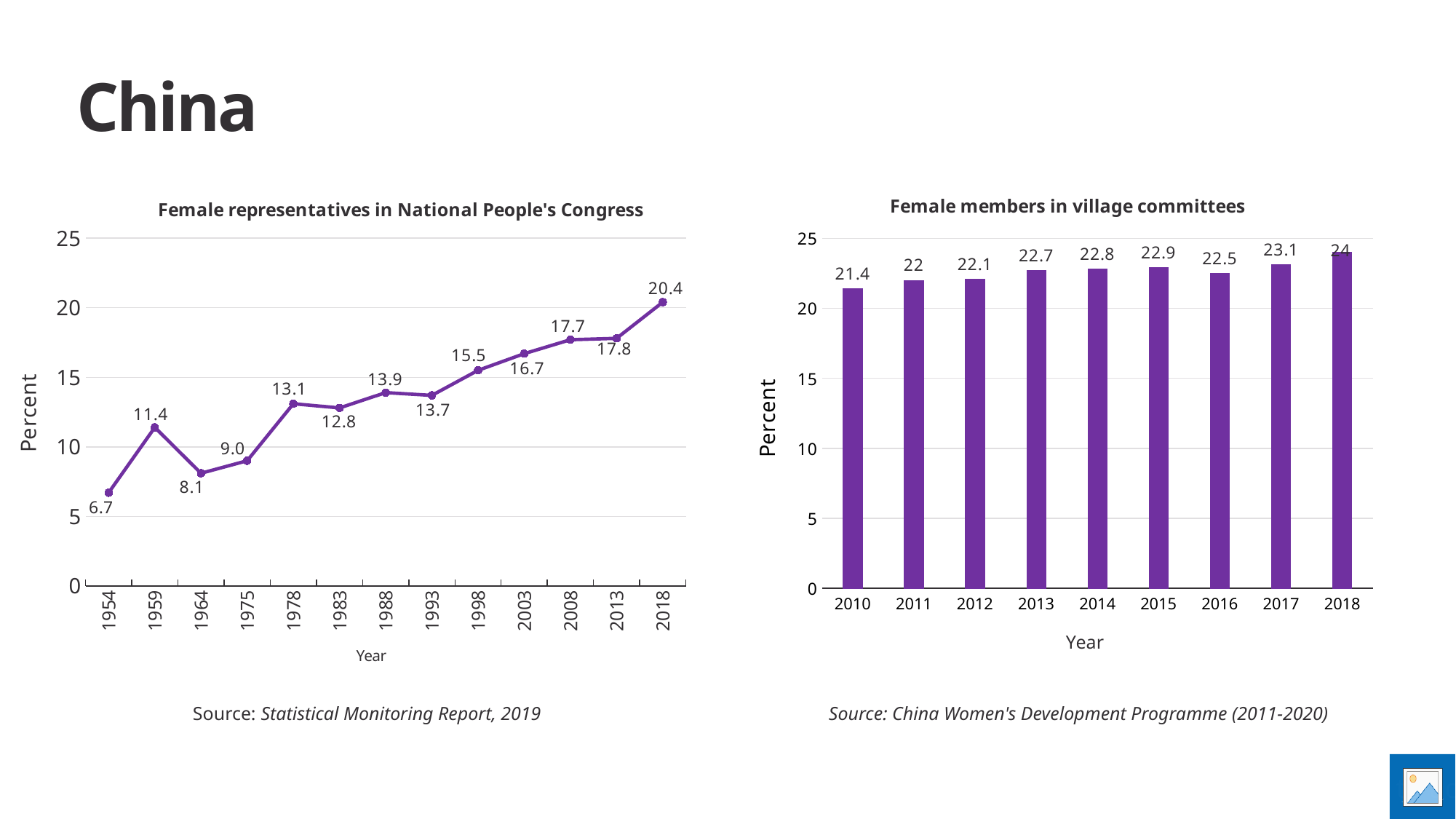
In the 'Female representatives in National People's Congress' chart, what is the value for 2018? 20.4 What kind of chart is 'Female representatives in National People's Congress'? Line chart In the 'Female representatives in National People's Congress' chart, what is the difference between the values for 2018 and 2013? 2.6 In the 'Female representatives in National People's Congress' chart, which is larger, the value for 1959 or the value for 1964? 1959 In the 'Female members in village committees' chart, what is the difference between the values for 2018 and 2010? 2.6 What kind of chart is 'Female members in village committees'? Bar chart In the 'Female representatives in National People's Congress' chart, which year has the lowest value? 1954 How many data points are plotted in the 'Female representatives in National People's Congress' chart? 13 In the 'Female members in village committees' chart, what is the value for 2013? 22.7 In the 'Female representatives in National People's Congress' chart, what is the value for 1954? 6.7 How many bars are in the 'Female members in village committees' chart? 9 In the 'Female members in village committees' chart, which year has the highest value? 2018